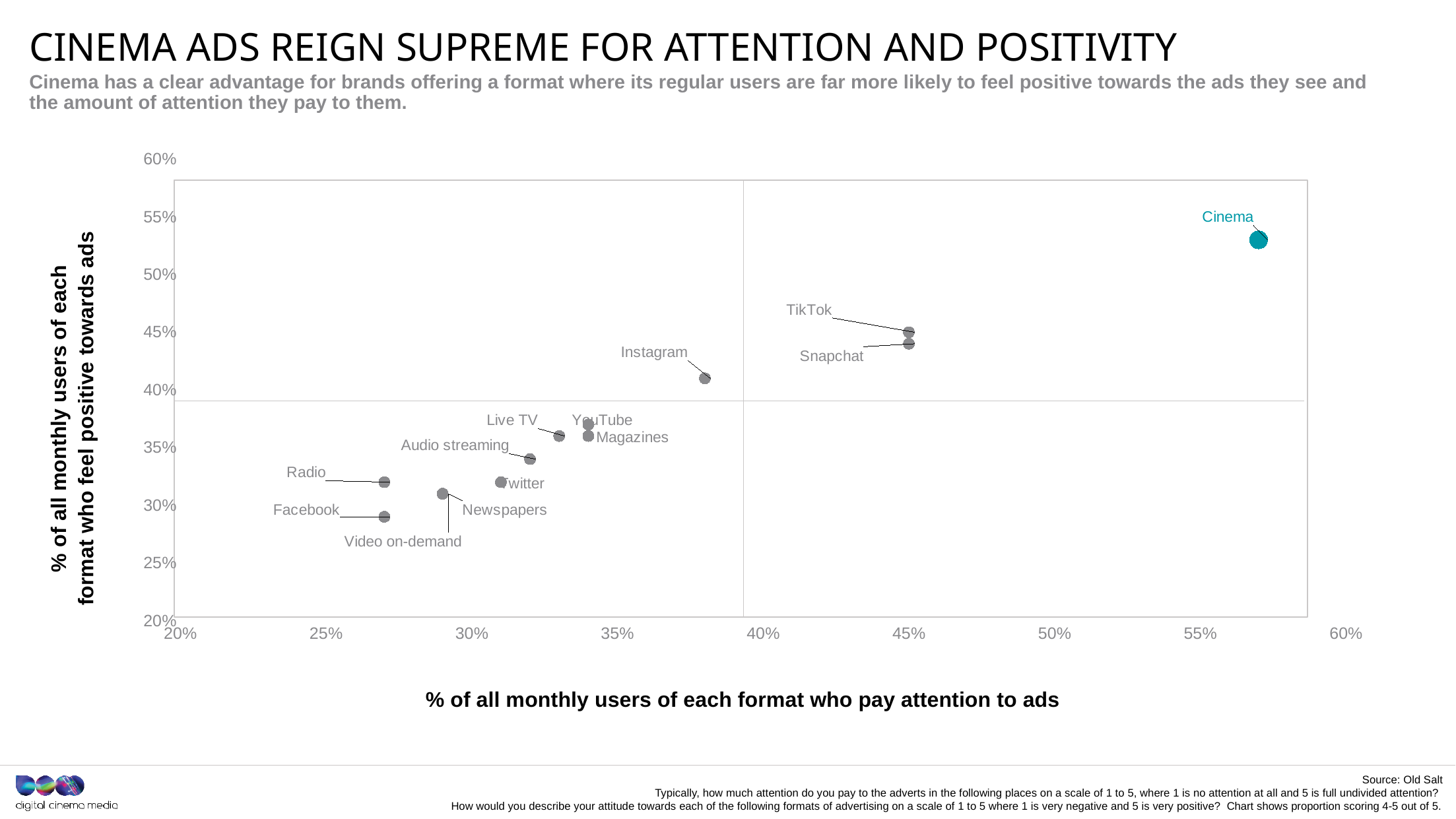
Is the percentage of Radio users who pay attention to ads greater or less than 30%? less Which format has the lowest percentage of monthly users who feel positive towards ads? Facebook What is the title of the horizontal axis of the chart? % of all monthly users of each format who pay attention to ads Is the percentage of Instagram users who pay attention to ads greater or less than 40%? less Which format has a higher percentage of users who pay attention to ads, TikTok or Instagram? TikTok Is the percentage of Cinema users who pay attention to ads greater or less than 55%? greater Which format has the highest percentage of monthly users who pay attention to ads? Cinema Which format has a higher percentage of users who feel positive towards ads, Cinema or Snapchat? Cinema What kind of chart is shown on the slide? Scatter chart Which format has the highest percentage of monthly users who feel positive towards ads? Cinema How many advertising formats are labelled on the chart? 13